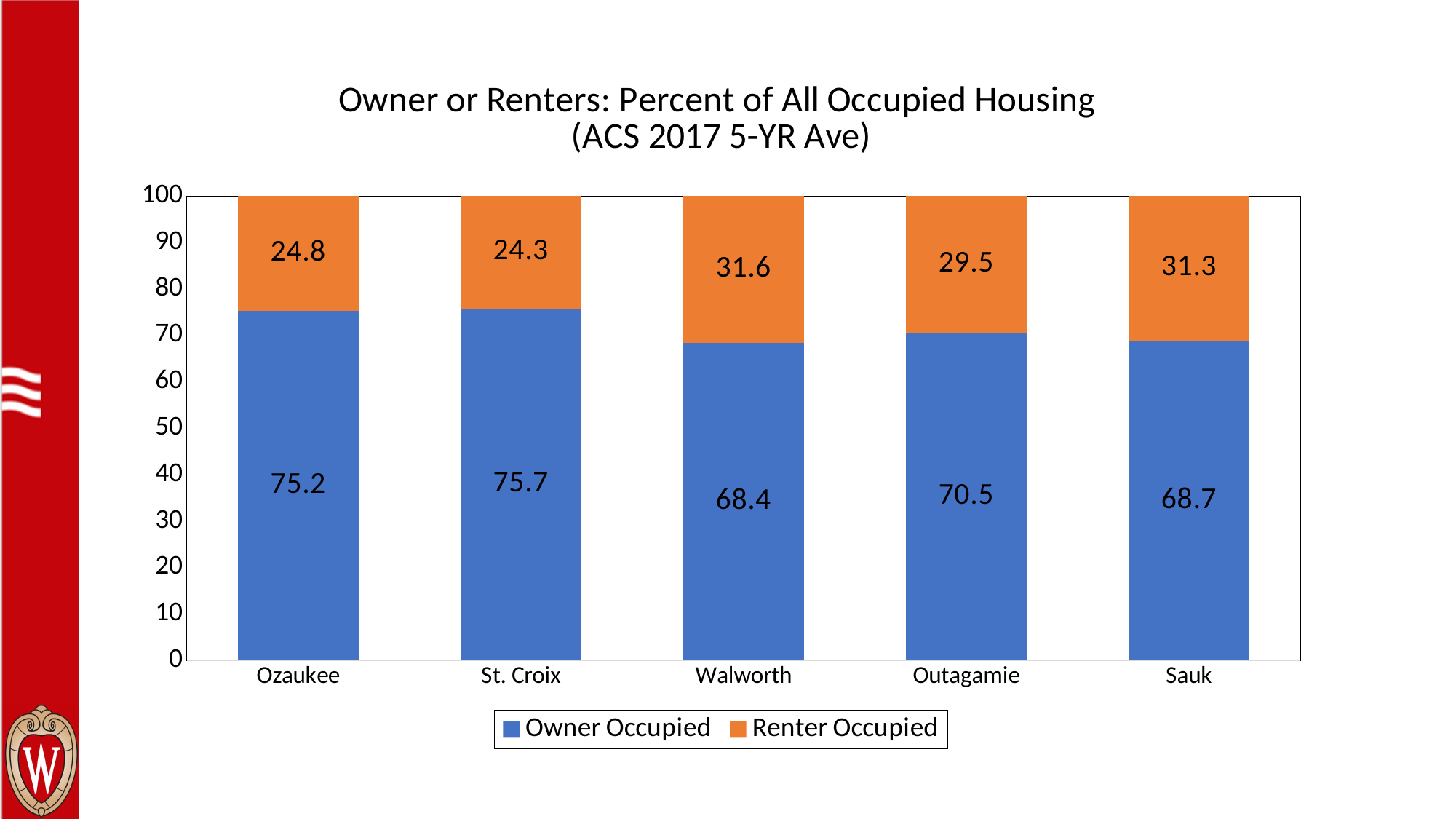
What kind of chart is shown on the slide? Stacked bar chart Which county has the highest Renter Occupied value? Walworth What is the difference between the Owner Occupied values for St. Croix and Sauk? 7 What is the Owner Occupied value for Outagamie? 70.5 Which county has the highest Owner Occupied value? St. Croix What is the Renter Occupied value for Walworth? 31.6 Which county has the lowest Owner Occupied value? Walworth Which is larger, the Renter Occupied value for Outagamie or for Sauk? Sauk How many counties are shown on the x axis? 5 What is the Owner Occupied value for Ozaukee? 75.2 What is the total of the stacked bar for Ozaukee? 100 How many series does the legend list? 2